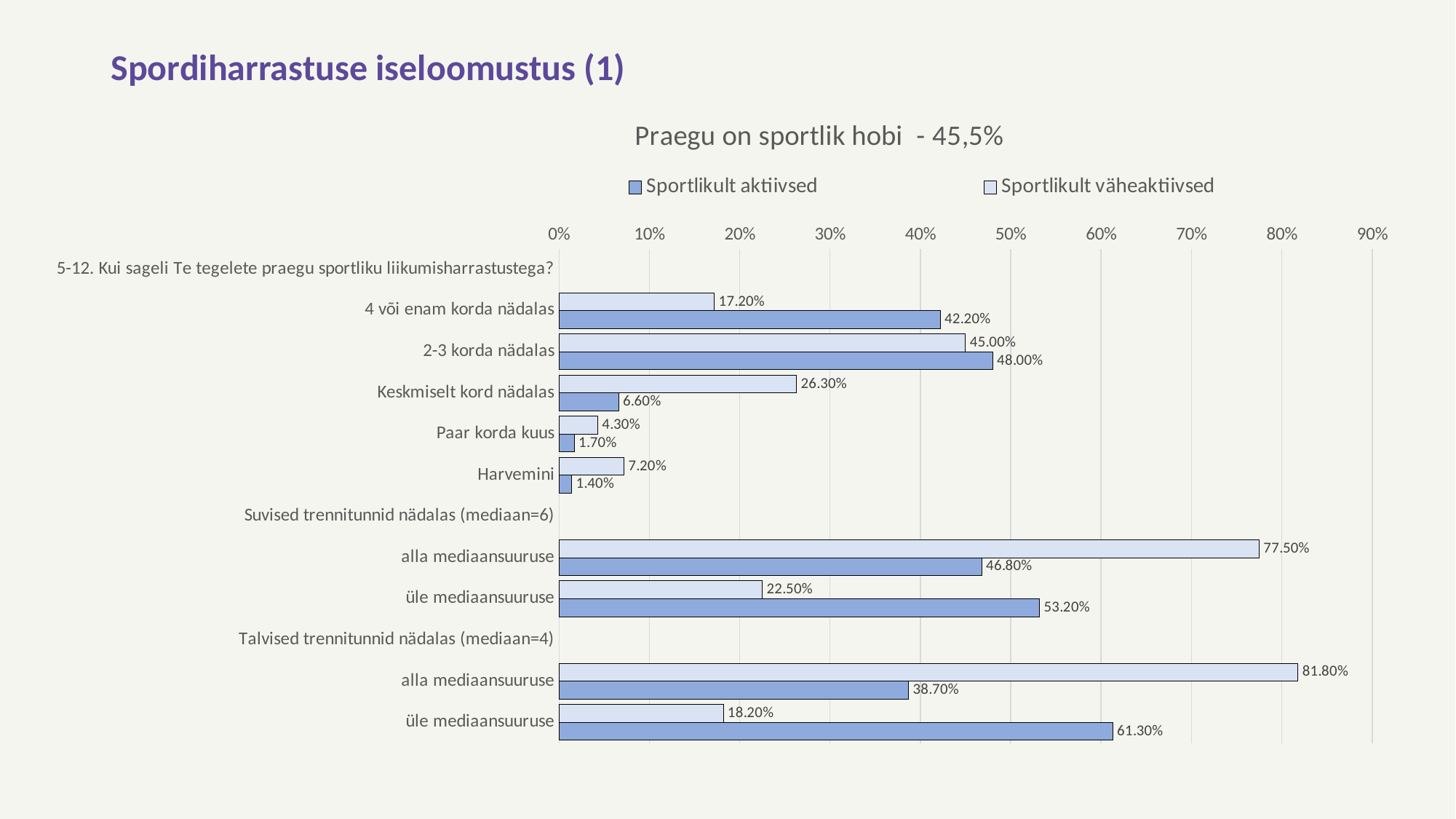
What kind of chart is shown on the slide? bar chart What is the value for 'Sportlikult aktiivsed' in the 'üle mediaansuuruse' category under 'Suvised trennitunnid nädalas (mediaan=6)'? 53.20% What is the difference between the 'Sportlikult aktiivsed' and 'Sportlikult väheaktiivsed' values for '4 või enam korda nädalas'? 25.00% Among the frequency categories under '5-12. Kui sageli Te tegelete praegu sportliku liikumisharrastustega?', which has the lowest value for 'Sportlikult aktiivsed'? Harvemini What is the value for 'Sportlikult aktiivsed' in the '4 või enam korda nädalas' category? 42.20% What is the title of the chart? Praegu on sportlik hobi - 45,5% How many series does the chart legend list? 2 What is the value for 'Sportlikult väheaktiivsed' in the 'alla mediaansuuruse' category under 'Talvised trennitunnid nädalas (mediaan=4)'? 81.80% What is the value for 'Sportlikult väheaktiivsed' in the 'Keskmiselt kord nädalas' category? 26.30% Is the 'Sportlikult aktiivsed' value for 'üle mediaansuuruse' under 'Talvised trennitunnid nädalas (mediaan=4)' greater or less than 60%? greater Which series has the larger value for 'Paar korda kuus'? Sportlikult väheaktiivsed Among the frequency categories under '5-12. Kui sageli Te tegelete praegu sportliku liikumisharrastustega?', which has the highest value for 'Sportlikult väheaktiivsed'? 2-3 korda nädalas